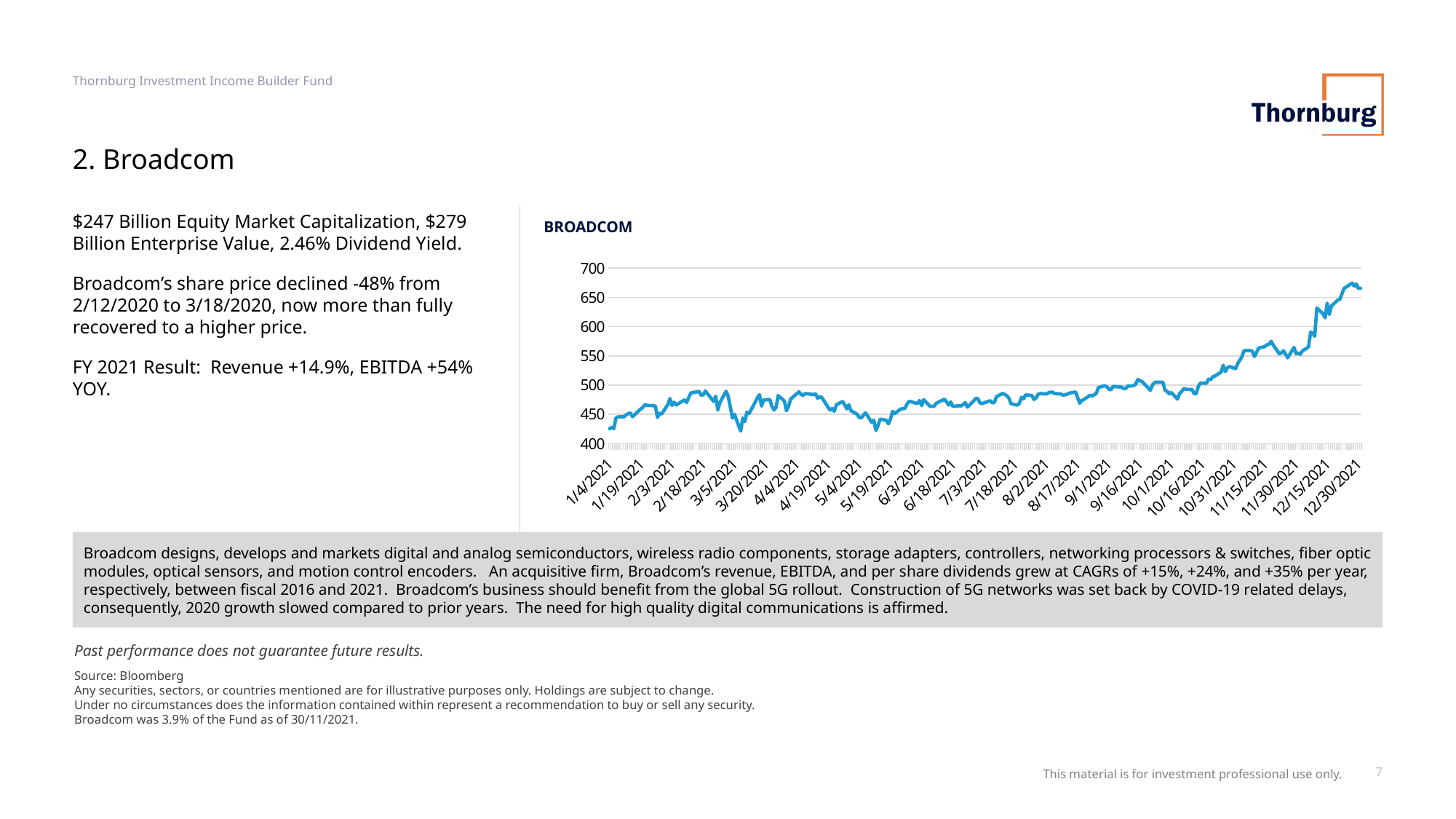
Is the value at 10/1/2021 greater or less than 500? less Is the value at 1/4/2021 greater or less than 450? less What is the title of the chart? BROADCOM What kind of chart is shown on the slide? line chart Overall, does the line rise or fall from 1/4/2021 to 12/30/2021? rise Is the value at 12/30/2021 greater or less than 650? greater In which month does the line reach its highest value? December 2021 Which is larger, the value at 1/4/2021 or the value at 12/30/2021? 12/30/2021 What is the highest tick value shown on the y axis? 700 How many date labels are shown on the x axis? 25